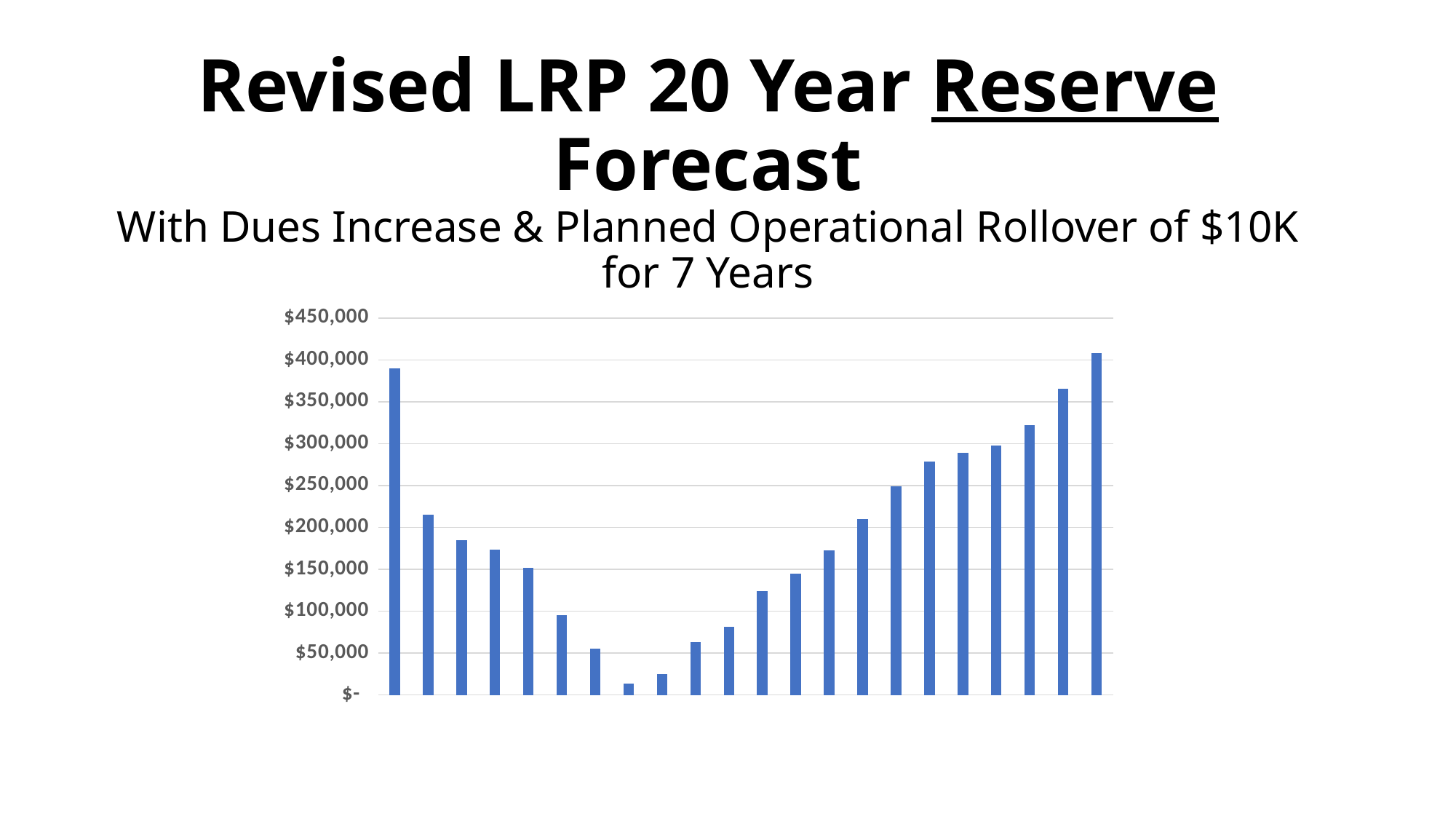
Which bar is the tallest in the chart? the rightmost (last) bar Which is larger, the leftmost bar or the rightmost bar? the rightmost bar Is the value of the second bar from the left greater or less than $200,000? greater What kind of chart is shown on the slide? bar chart Is the value of the rightmost bar greater or less than $400,000? greater What is the title of the slide containing the chart? Revised LRP 20 Year Reserve Forecast Is the value of the leftmost bar greater or less than $350,000? greater What is the highest value shown on the vertical axis? $450,000 How do the values change across the chart from left to right? they fall to a low near the middle, then rise Which bar is the shortest in the chart? the eighth bar from the left How many bars are plotted in the chart? 22